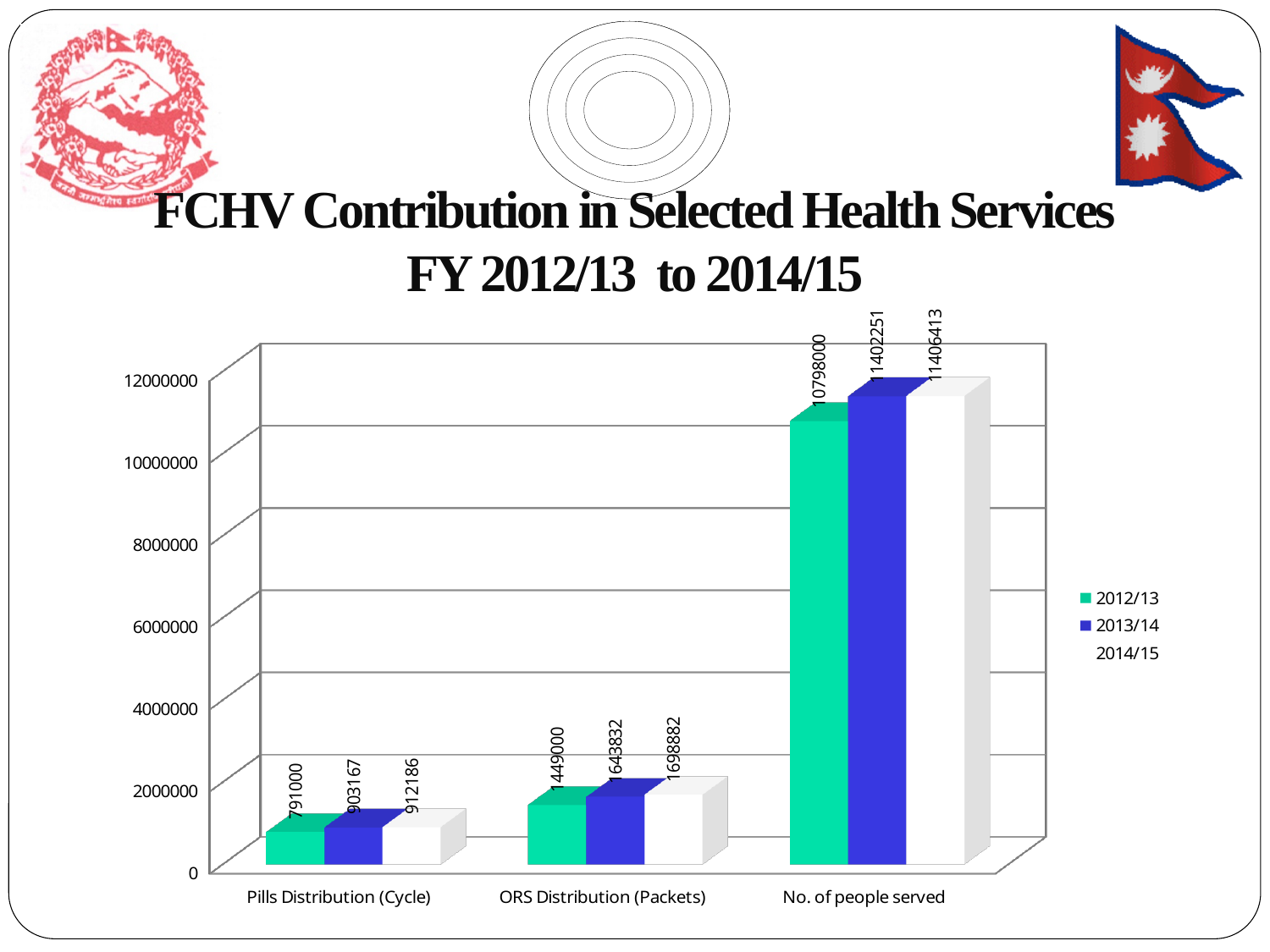
What is the difference between the 2014/15 and 2012/13 values for ORS Distribution (Packets)? 249882 Which category has the highest value in 2013/14? No. of people served What is the value for No. of people served in 2014/15? 11406413 How many series does the legend list? 3 Which category has the lowest value in 2012/13? Pills Distribution (Cycle) What kind of chart is shown on the slide? bar chart Is the value for No. of people served in 2012/13 greater or less than 10000000? greater What is the value for Pills Distribution (Cycle) in 2014/15? 912186 What is the value for ORS Distribution (Packets) in 2013/14? 1643832 What is the value for Pills Distribution (Cycle) in 2012/13? 791000 How many categories are shown on the x axis? 3 Which is larger for Pills Distribution (Cycle): the 2012/13 value or the 2013/14 value? 2013/14